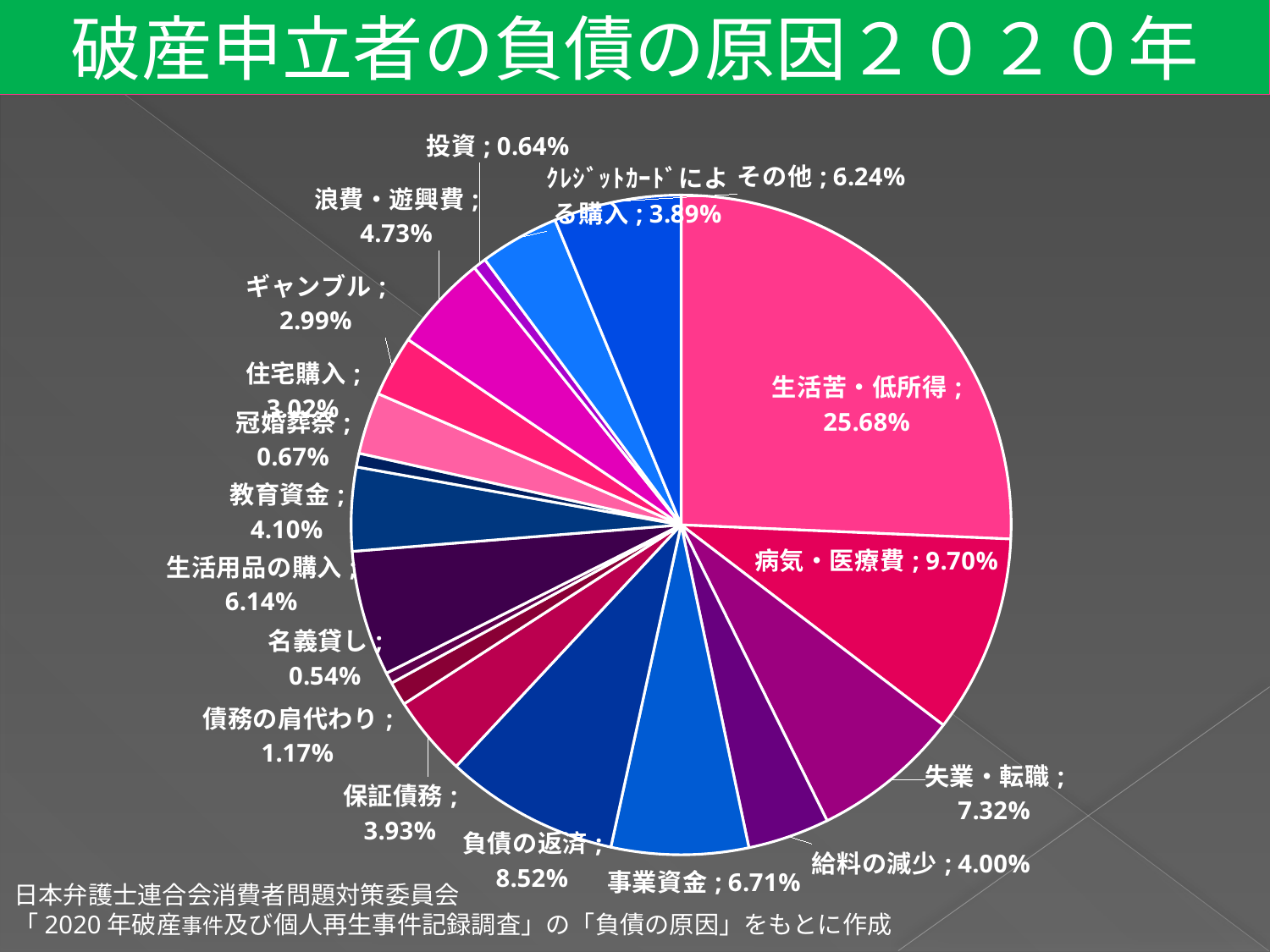
Which category has the largest share of the pie? 生活苦・低所得 What is the title of the chart? 破産申立者の負債の原因２０２０年 How many categories are shown in the pie chart? 18 What is the share for 教育資金? 4.10% What is the share for 生活苦・低所得? 25.68% What is the share for 病気・医療費? 9.70% What is the difference between the shares for 失業・転職 and 給料の減少? 3.32% What kind of chart is shown on the slide? pie chart Which category has the smallest share of the pie? 名義貸し Which is larger, the share for 事業資金 or the share for 生活用品の購入? 事業資金 What is the share for 負債の返済? 8.52% What is the share for その他? 6.24%